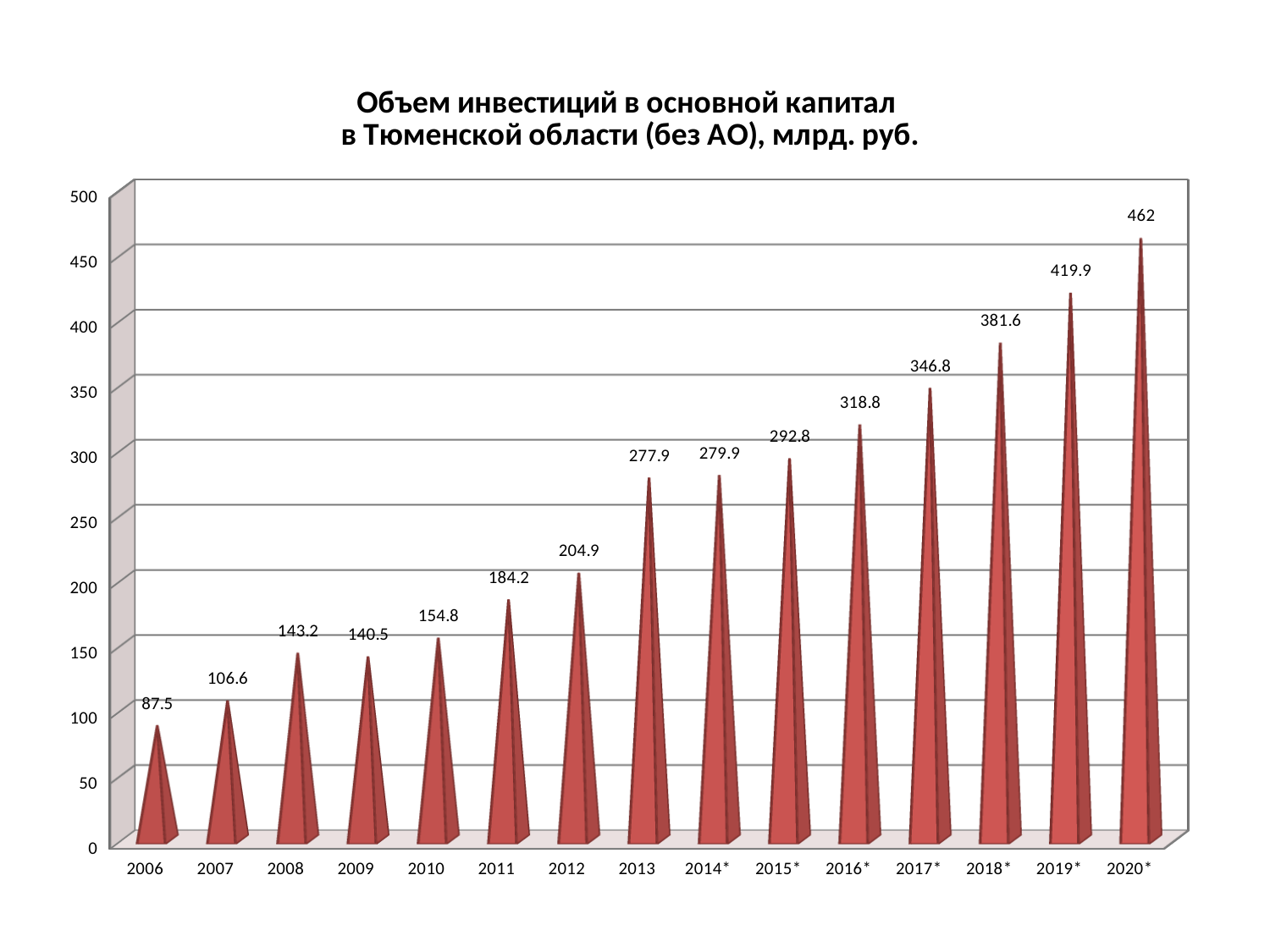
Is the value for 2018* greater or less than 350? greater What is the value for 2006? 87.5 Which year has the highest value? 2020* What is the value for 2012? 204.9 Which year has the lowest value? 2006 How many years are shown on the x axis? 15 What is the value for 2017*? 346.8 What is the difference between the values for 2020* and 2019*? 42.1 What kind of chart is this? bar chart Which is larger, the value for 2010 or the value for 2011? 2011 Do the values generally rise or fall from 2006 to 2020*? rise What is the difference between the values for 2008 and 2009? 2.7